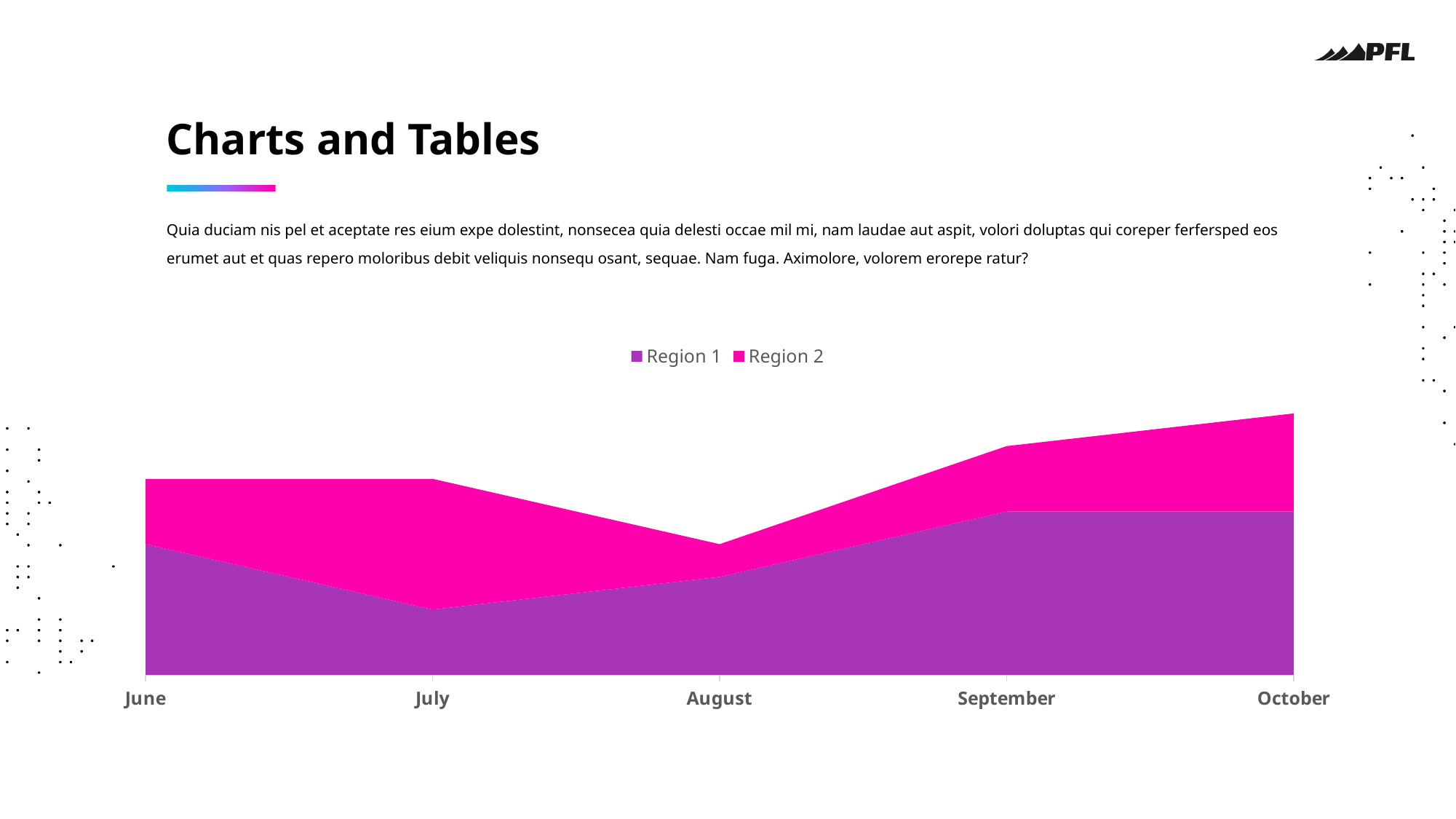
What kind of chart is shown on the slide? Stacked area chart Does the Region 1 value rise or fall from July to October? Rise In which month is the Region 2 value lowest? August In which month is the combined (stacked) total of Region 1 and Region 2 highest? October Which colour represents Region 2 in the chart? Pink In which month is the Region 1 value lowest? July How many months are shown along the x axis of the chart? 5 How many series does the chart's legend list? 2 What are the two series named in the chart's legend? Region 1 and Region 2 Is the Region 1 value larger in June or in July? June Does the combined total of both regions rise or fall from June to August? Fall In which month is the combined (stacked) total of Region 1 and Region 2 lowest? August